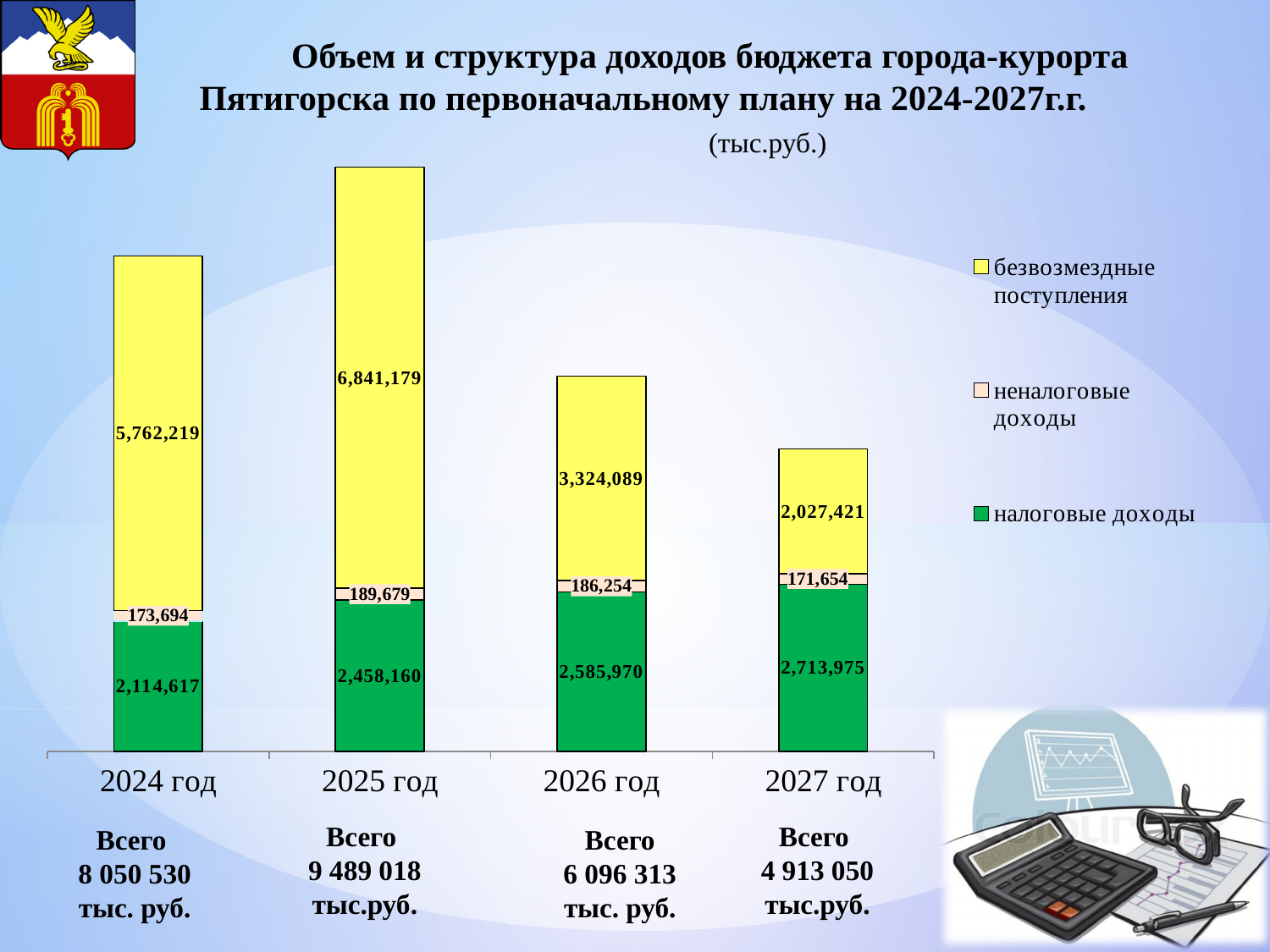
What is the value of налоговые доходы for 2024 год? 2,114,617 What type of chart is shown on the slide? stacked bar chart How many series does the legend list? 3 Do налоговые доходы rise or fall from 2024 год to 2027 год? rise What is the value of безвозмездные поступления for 2025 год? 6,841,179 In which year are неналоговые доходы the lowest? 2027 год What is the difference between налоговые доходы in 2027 год and in 2024 год? 599,358 Which is larger: безвозмездные поступления in 2026 год or in 2027 год? 2026 год How many years (categories) are shown on the x axis? 4 What is the total of the stacked bar for 2027 год? 4 913 050 In which year are безвозмездные поступления the highest? 2025 год What is the value of неналоговые доходы for 2026 год? 186,254